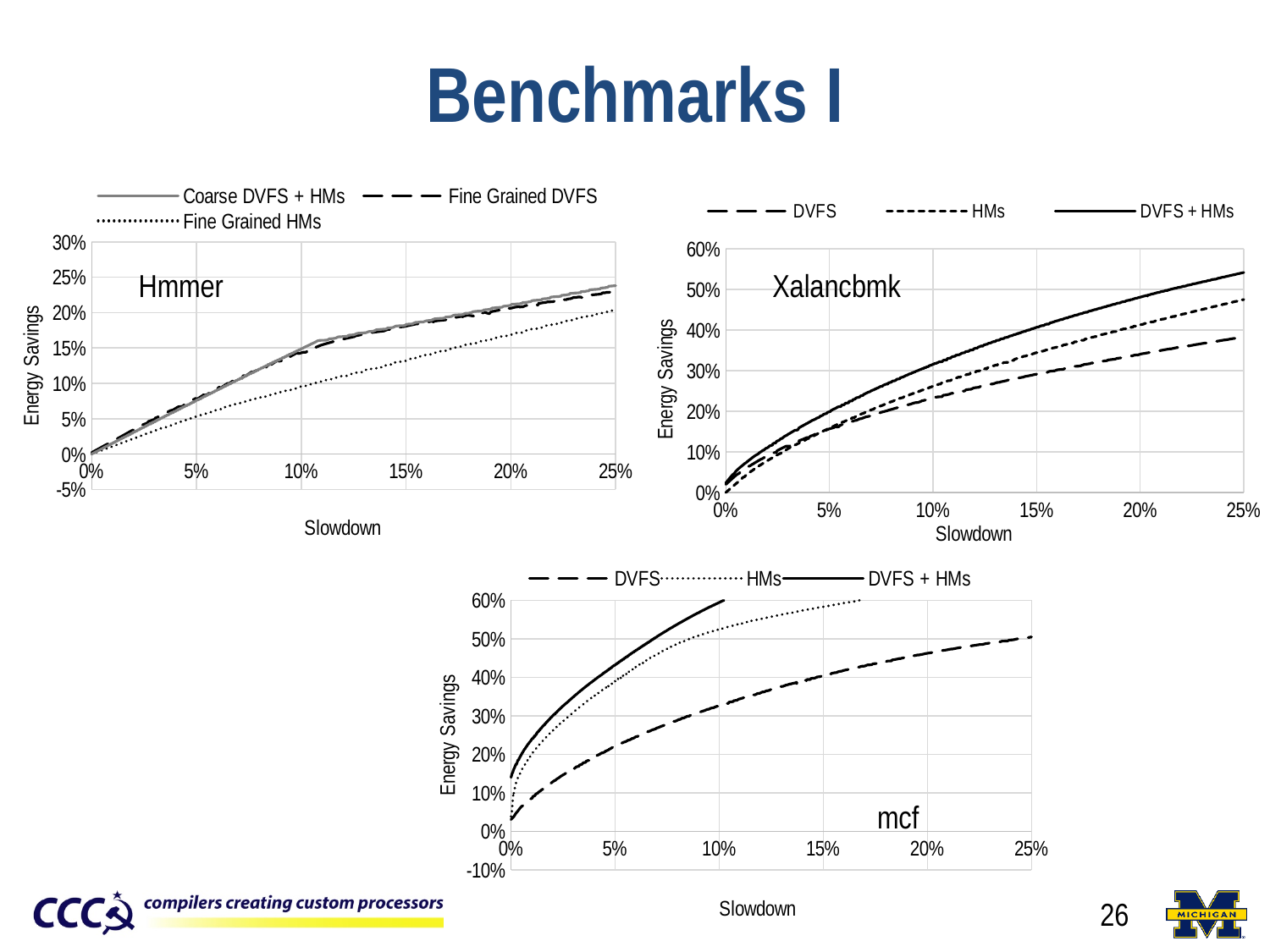
In the Xalancbmk chart, is the value for DVFS + HMs at 25% slowdown greater or less than 50%? greater In the Xalancbmk chart, which series has the lowest energy savings at 25% slowdown? DVFS In the Hmmer chart, do the energy savings rise or fall as slowdown increases? rise In the Hmmer chart, at 25% slowdown, which is larger: Coarse DVFS + HMs or Fine Grained HMs? Coarse DVFS + HMs How many charts are shown on the slide? 3 What is the x-axis title of the mcf chart? Slowdown How many series does the legend of the Hmmer chart list? 3 In the mcf chart, is the value for DVFS at 20% slowdown greater or less than 50%? less How many series does the legend of the Xalancbmk chart list? 3 In the Hmmer chart, is the value for Coarse DVFS + HMs at 25% slowdown greater or less than 20%? greater In the mcf chart, at 10% slowdown, which is larger: DVFS + HMs or DVFS? DVFS + HMs What kind of chart is the Hmmer chart? line chart